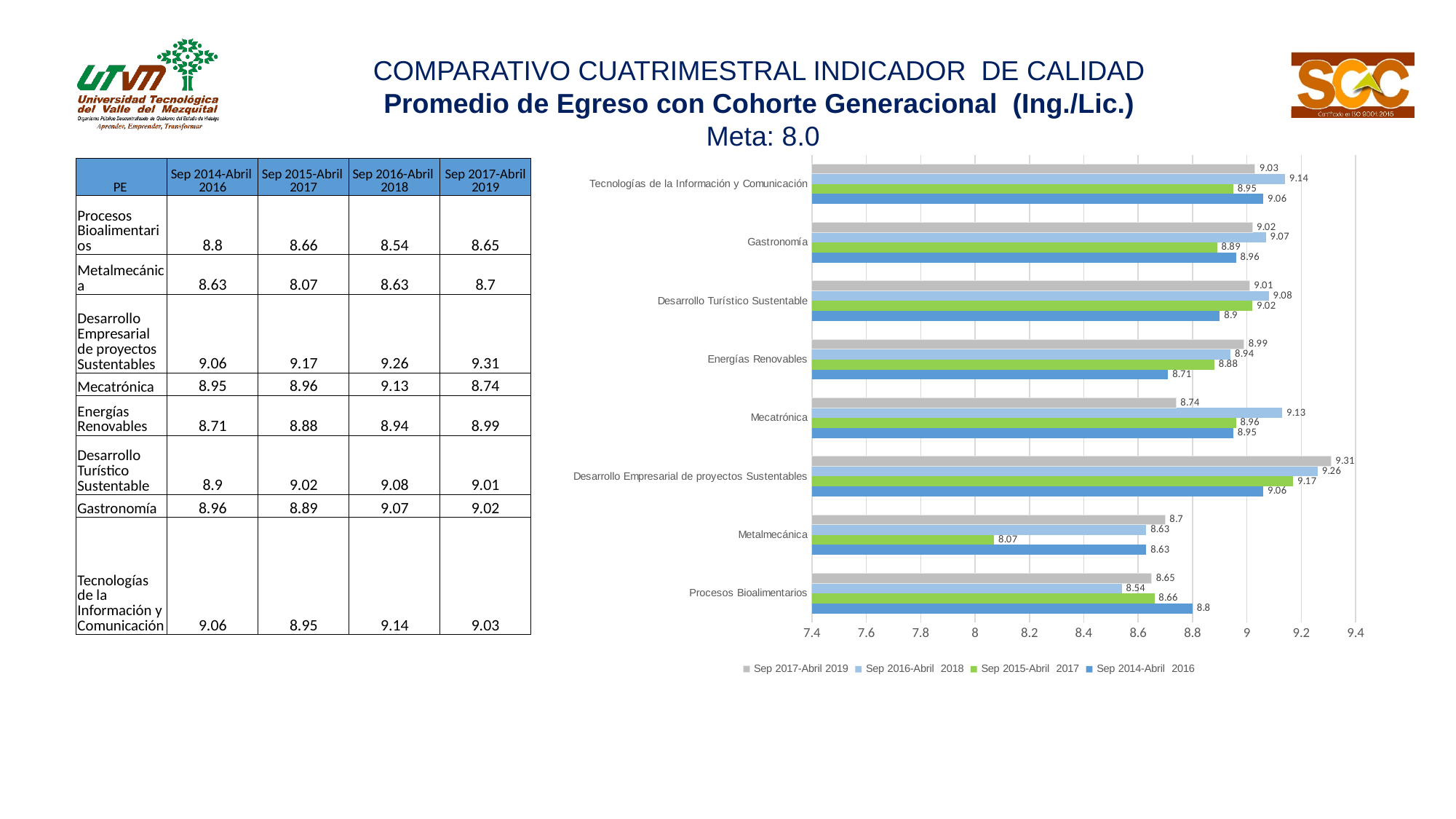
Which category has the lowest value in the Sep 2014-Abril 2016 series? Metalmecánica What is the value for Energías Renovables in the Sep 2014-Abril 2016 series? 8.71 Which category has the highest value in the Sep 2016-Abril 2018 series? Desarrollo Empresarial de proyectos Sustentables How many categories (programs) are shown on the chart? 8 What is the value for Metalmecánica in the Sep 2015-Abril 2017 series? 8.07 Is the value for Procesos Bioalimentarios in the Sep 2016-Abril 2018 series greater or less than 8.6? less For Gastronomía, which is larger: the Sep 2014-Abril 2016 value or the Sep 2015-Abril 2017 value? Sep 2014-Abril 2016 How many series does the legend list? 4 What kind of chart is shown on the slide? bar chart What colour represents the Sep 2015-Abril 2017 series in the legend? green For Mecatrónica, what is the difference between the Sep 2016-Abril 2018 value and the Sep 2017-Abril 2019 value? 0.39 What is the value for Desarrollo Empresarial de proyectos Sustentables in the Sep 2017-Abril 2019 series? 9.31